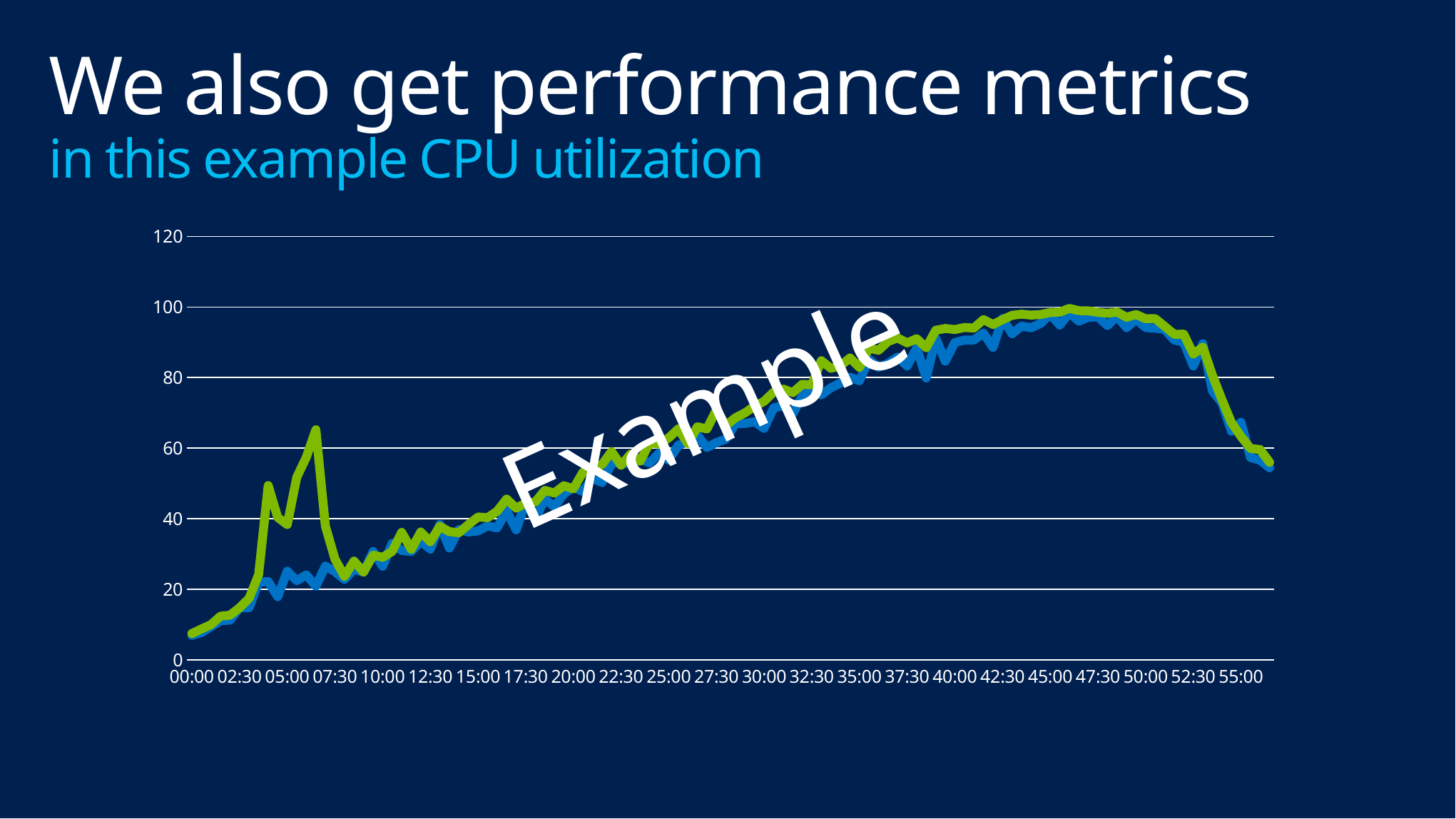
How many time labels are shown along the x axis of the chart? 23 Is the value of the lines at 45:00 greater or less than 80? greater Is the peak of the green line near 07:30 greater or less than 40? greater What kind of chart is shown on the slide? line chart Do the values rise or fall along the x axis between 10:00 and 45:00? rise What is the highest value shown on the y axis of the chart? 120 Is the value of the lines at 00:00 greater or less than 20? less At which x-axis time do the lines have their lowest values? 00:00 How many lines are plotted on the chart? 2 What colours are the two lines on the chart? green and blue